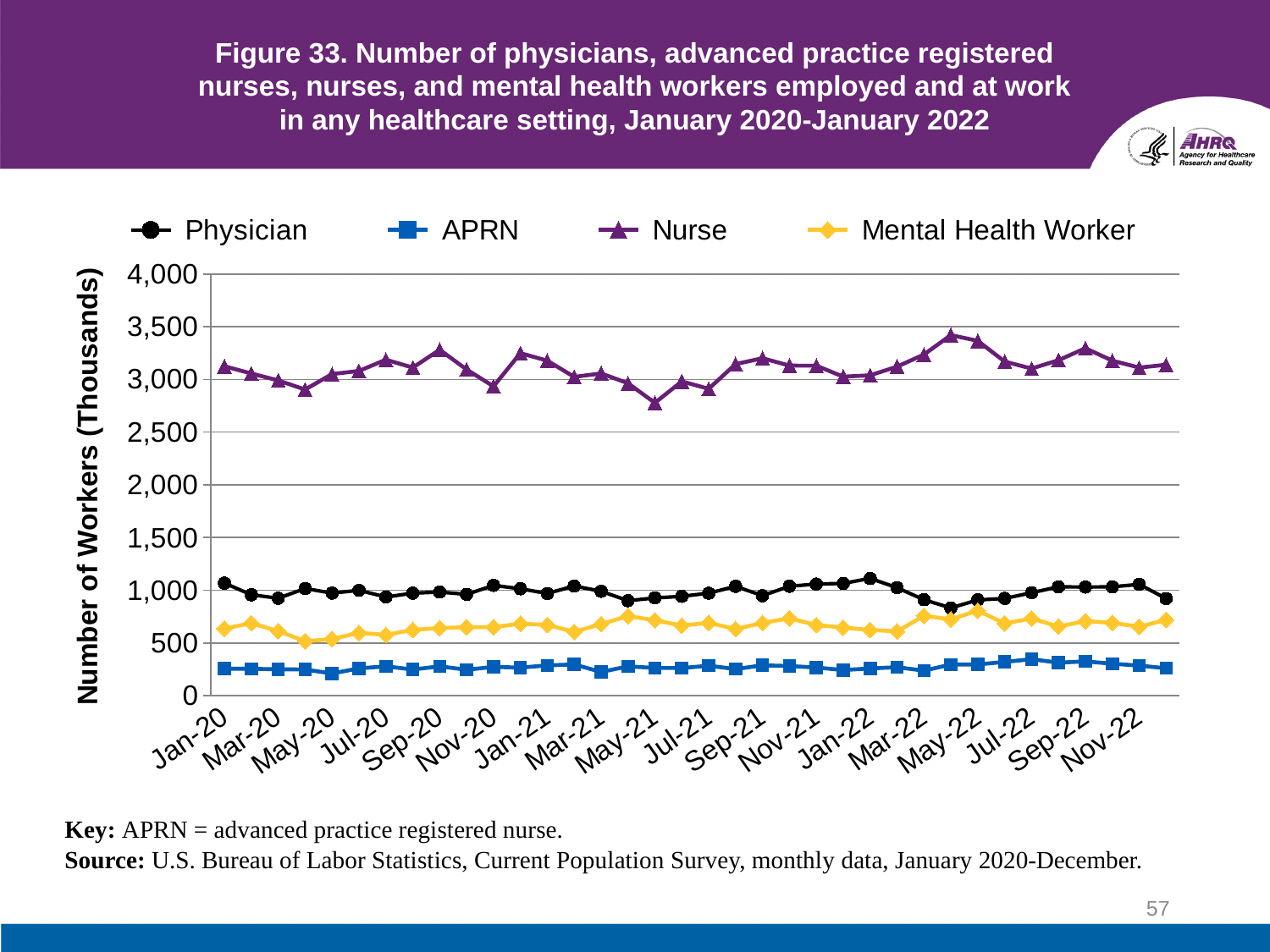
Is the value for APRN in Jan-20 greater or less than 500? less Is the value for Mental Health Worker in Jan-22 greater or less than 1,000? less Is the value for Physician in Jan-22 greater or less than 1,000? greater How many series does the legend list? 4 Which series has the lowest values throughout the chart? APRN What does the key say APRN stands for? advanced practice registered nurse In Jan-20, which series has the larger value, Physician or Mental Health Worker? Physician Which series has the highest values throughout the chart? Nurse What kind of chart is shown on the slide? line chart What is the label on the vertical axis? Number of Workers (Thousands)